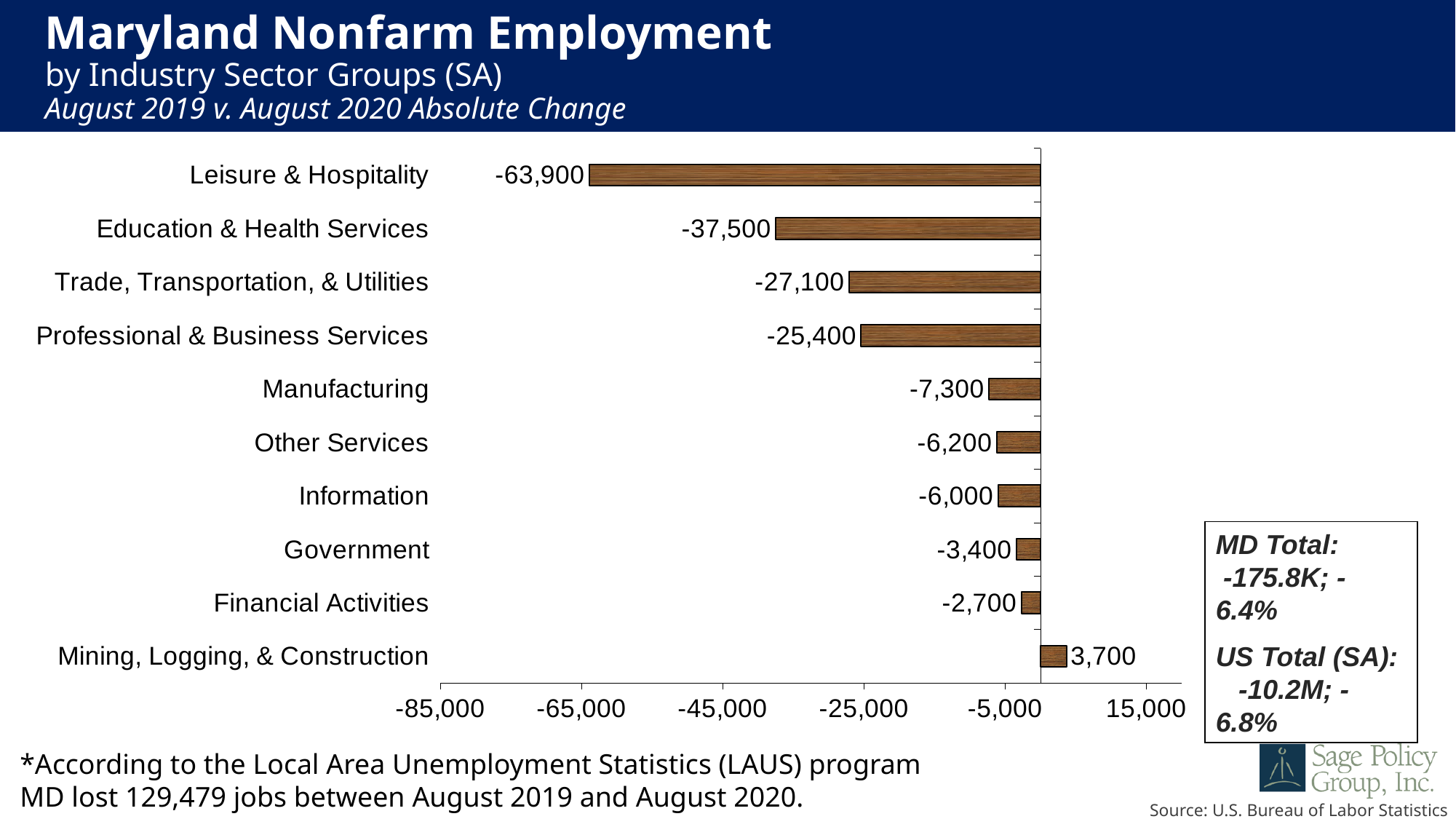
Which industry sector group is the only one with a positive change in employment? Mining, Logging, & Construction Which sector had a larger decline: Trade, Transportation, & Utilities or Professional & Business Services? Trade, Transportation, & Utilities What is the absolute change in employment for Leisure & Hospitality? -63,900 What is the difference between the changes for Leisure & Hospitality and Education & Health Services? 26,400 Which industry sector group has the largest decline in employment? Leisure & Hospitality What is the difference between the changes for Manufacturing and Other Services? 1,100 What kind of chart is shown on the slide? Bar chart What is the absolute change in employment for Mining, Logging, & Construction? 3,700 How many industry sector groups are shown in the chart? 10 What is the absolute change in employment for Education & Health Services? -37,500 What is the MD Total change shown in the text box on the slide? -175.8K; -6.4% What is the absolute change in employment for Government? -3,400